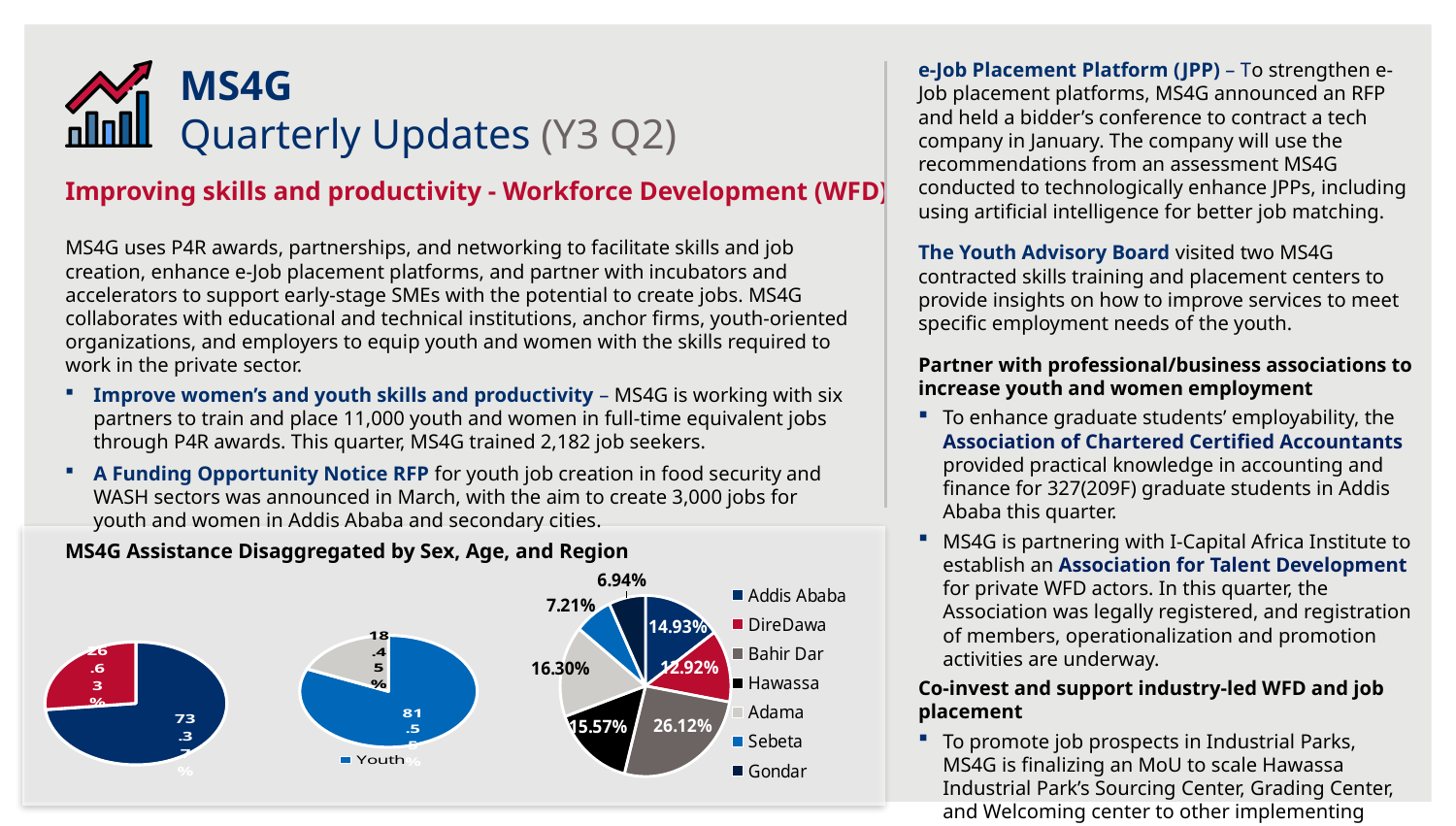
In the leftmost pie chart, what is the value of the larger slice? 73.37% In the region pie chart (right), what share is shown for Adama? 16.30% What is the title above the three pie charts? MS4G Assistance Disaggregated by Sex, Age, and Region In the region pie chart (right), what share is shown for Gondar? 6.94% In the region pie chart (right), what share is shown for Sebeta? 7.21% In the region pie chart (right), which region has the largest share? Bahir Dar What type of chart is used to show MS4G assistance by region? Pie chart In the region pie chart (right), what is the difference between the shares for Bahir Dar and Gondar? 19.18% In the region pie chart (right), which has the larger share, Hawassa or Addis Ababa? Hawassa In the region pie chart (right), what share is shown for Bahir Dar? 26.12% In the region pie chart (right), which region has the smallest share? Gondar How many regions are shown in the region pie chart (right)? 7